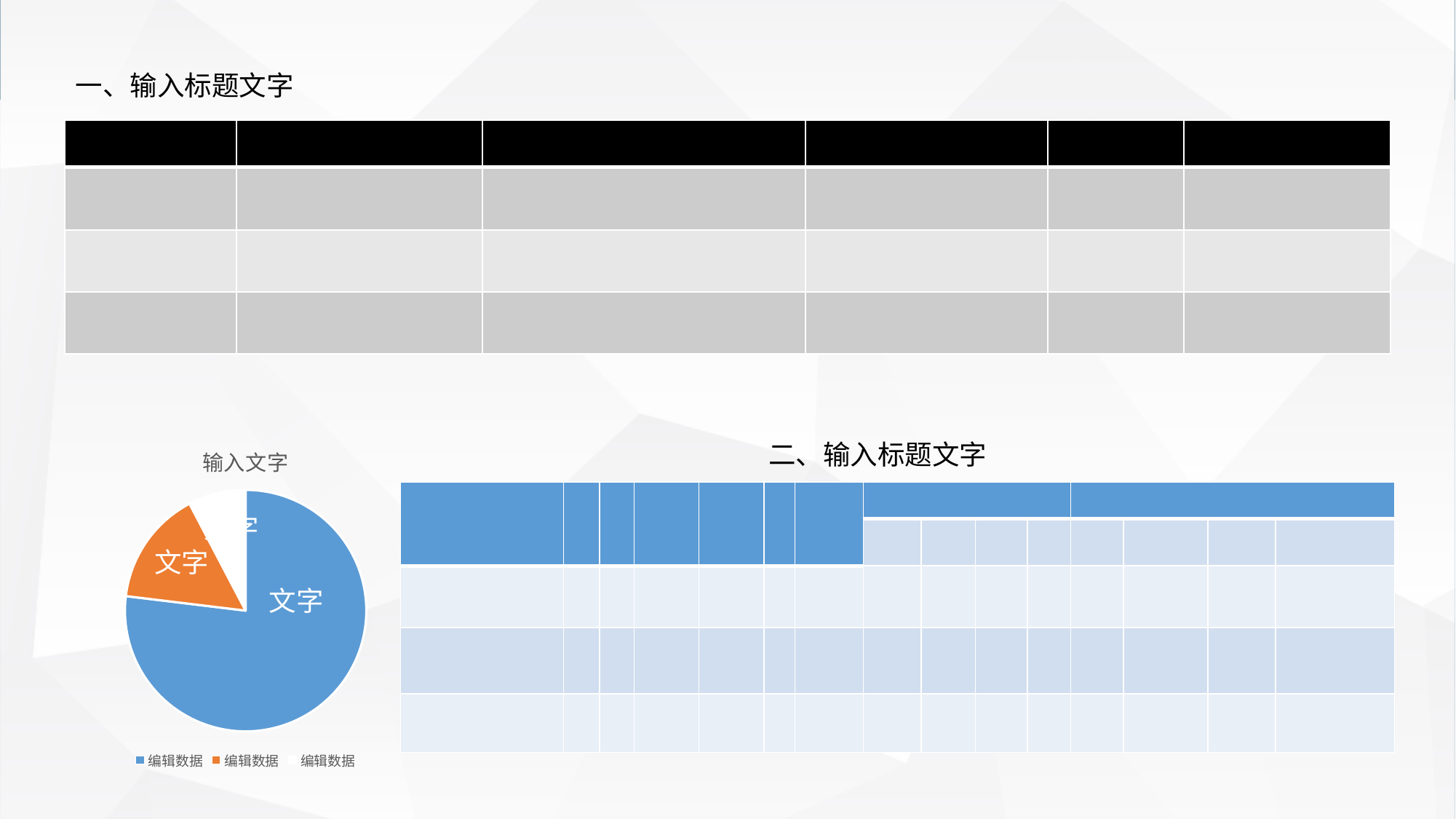
What text is used for the legend entries of the pie chart? 编辑数据 How many entries does the pie chart's legend list? 3 What kind of chart is shown on the slide? pie chart Does the blue slice take up more or less than half of the pie chart? more Which colour slice is the smallest in the pie chart? white How many slices does the pie chart have? 3 What is the title of the pie chart? 输入文字 Which colour slice is the largest in the pie chart? blue In the pie chart, which slice is larger, the blue one or the orange one? blue In the pie chart, which slice is larger, the orange one or the white one? orange